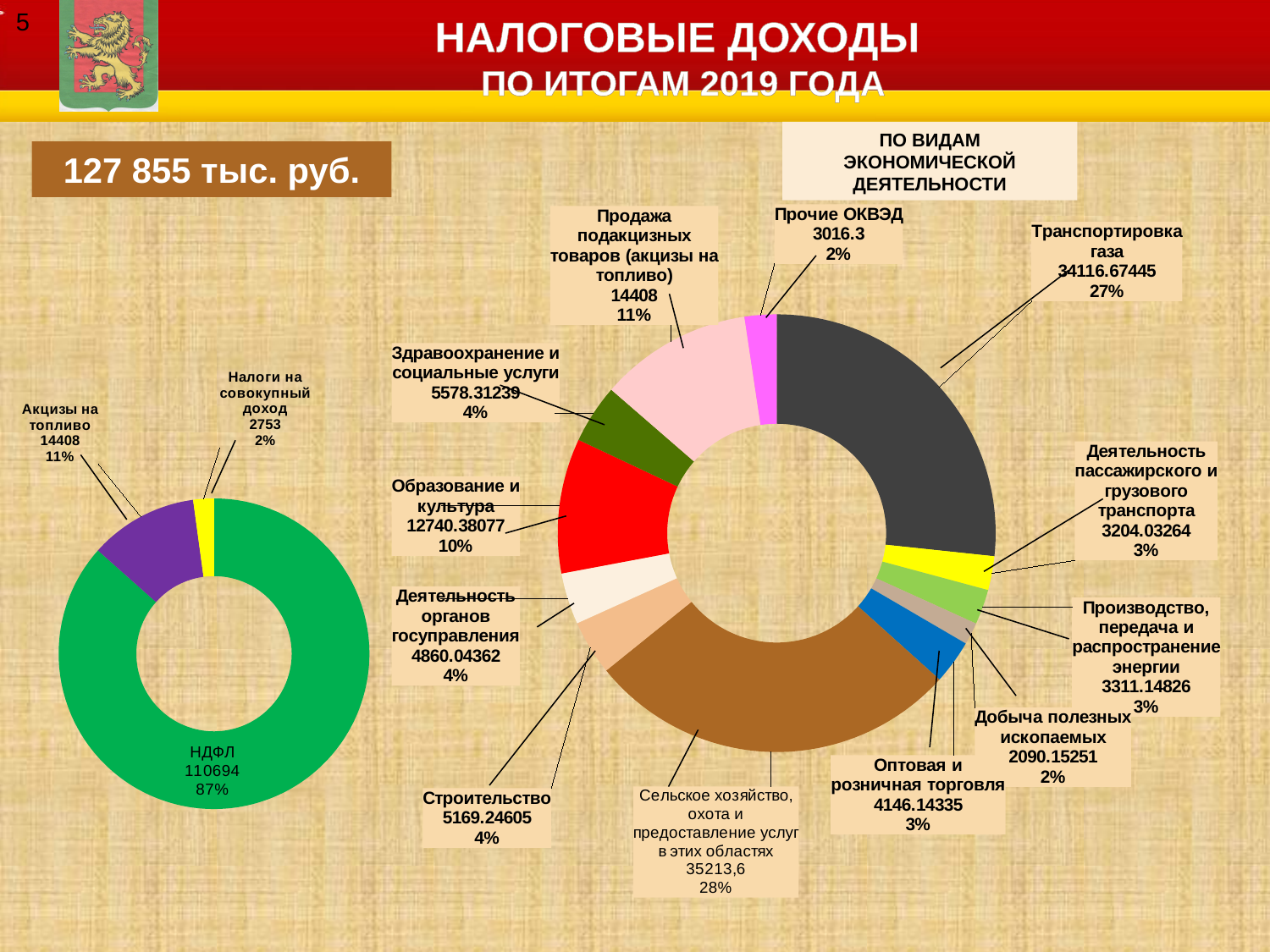
What total amount is shown in the box at the top left of the slide? 127 855 тыс. руб. In the chart titled 'ПО ВИДАМ ЭКОНОМИЧЕСКОЙ ДЕЯТЕЛЬНОСТИ', which category has the smallest value? Добыча полезных ископаемых In the chart titled 'ПО ВИДАМ ЭКОНОМИЧЕСКОЙ ДЕЯТЕЛЬНОСТИ', what share does Образование и культура represent? 10% In the left chart, what share of the total does Акцизы на топливо represent? 11% In the chart titled 'ПО ВИДАМ ЭКОНОМИЧЕСКОЙ ДЕЯТЕЛЬНОСТИ', how many categories are shown? 12 In the left chart, which category has the smallest value? Налоги на совокупный доход In the left chart, what value is shown for НДФЛ? 110694 In the chart titled 'ПО ВИДАМ ЭКОНОМИЧЕСКОЙ ДЕЯТЕЛЬНОСТИ', which is larger: Строительство or Оптовая и розничная торговля? Строительство In the chart titled 'ПО ВИДАМ ЭКОНОМИЧЕСКОЙ ДЕЯТЕЛЬНОСТИ', which category has the largest value? Сельское хозяйство, охота и предоставление услуг в этих областях In the chart titled 'ПО ВИДАМ ЭКОНОМИЧЕСКОЙ ДЕЯТЕЛЬНОСТИ', what value is shown for Транспортировка газа? 34116.67445 In the left chart, how many categories are shown? 3 What kind of chart is the left chart on the slide? Donut (pie) chart